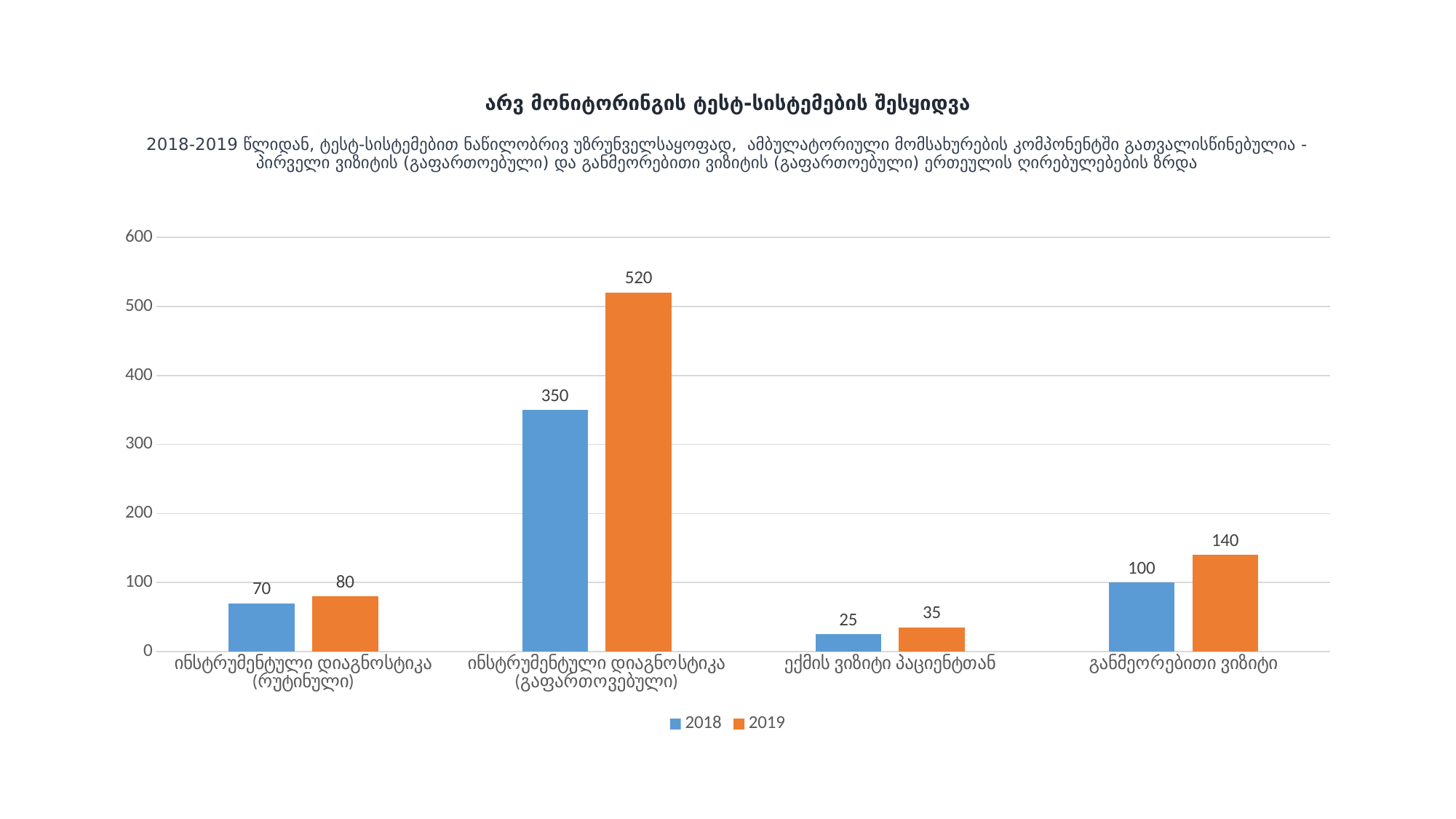
Which category has the highest 2019 value? ინსტრუმენტული დიაგნოსტიკა (გაფართოვებული) How many series does the legend list? 2 How many categories are shown on the x axis? 4 What is the 2018 value for ექიმის ვიზიტი პაციენტთან? 25 What is the 2019 value for ინსტრუმენტული დიაგნოსტიკა (გაფართოვებული)? 520 What is the difference between the 2019 and 2018 values for ინსტრუმენტული დიაგნოსტიკა (გაფართოვებული)? 170 What is the 2018 value for განმეორებითი ვიზიტი? 100 Which series is shown in orange? 2019 What kind of chart is shown on the slide? Bar chart What is the difference between the 2019 and 2018 values for განმეორებითი ვიზიტი? 40 Which is larger: the 2019 value for ინსტრუმენტული დიაგნოსტიკა (რუტინული) or the 2019 value for განმეორებითი ვიზიტი? განმეორებითი ვიზიტი Which category has the lowest 2018 value? ექმის ვიზიტი პაციენტთან